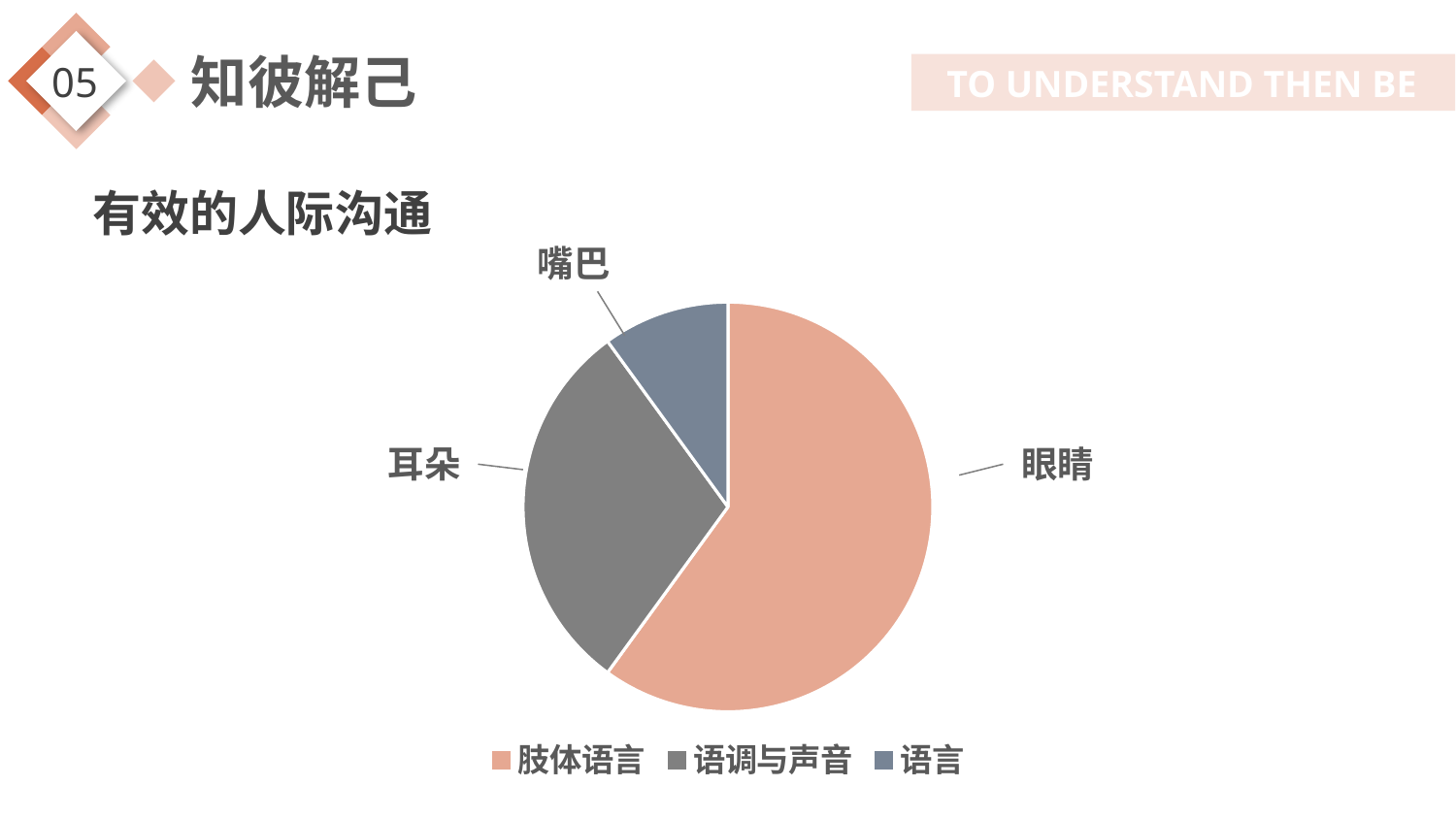
What kind of chart is shown on the slide? pie chart How many entries does the legend of the pie chart list? 3 Which slice is larger in the pie chart, 眼睛 or 耳朵? 眼睛 How many slices does the pie chart have? 3 Which slice of the pie chart is the largest? 眼睛 What is the title shown above the pie chart? 有效的人际沟通 Which slice is larger in the pie chart, 耳朵 or 嘴巴? 耳朵 Which legend entry of the pie chart is shown in grey? 语调与声音 Which slice of the pie chart is the smallest? 嘴巴 Which slice is smaller in the pie chart, 嘴巴 or 眼睛? 嘴巴